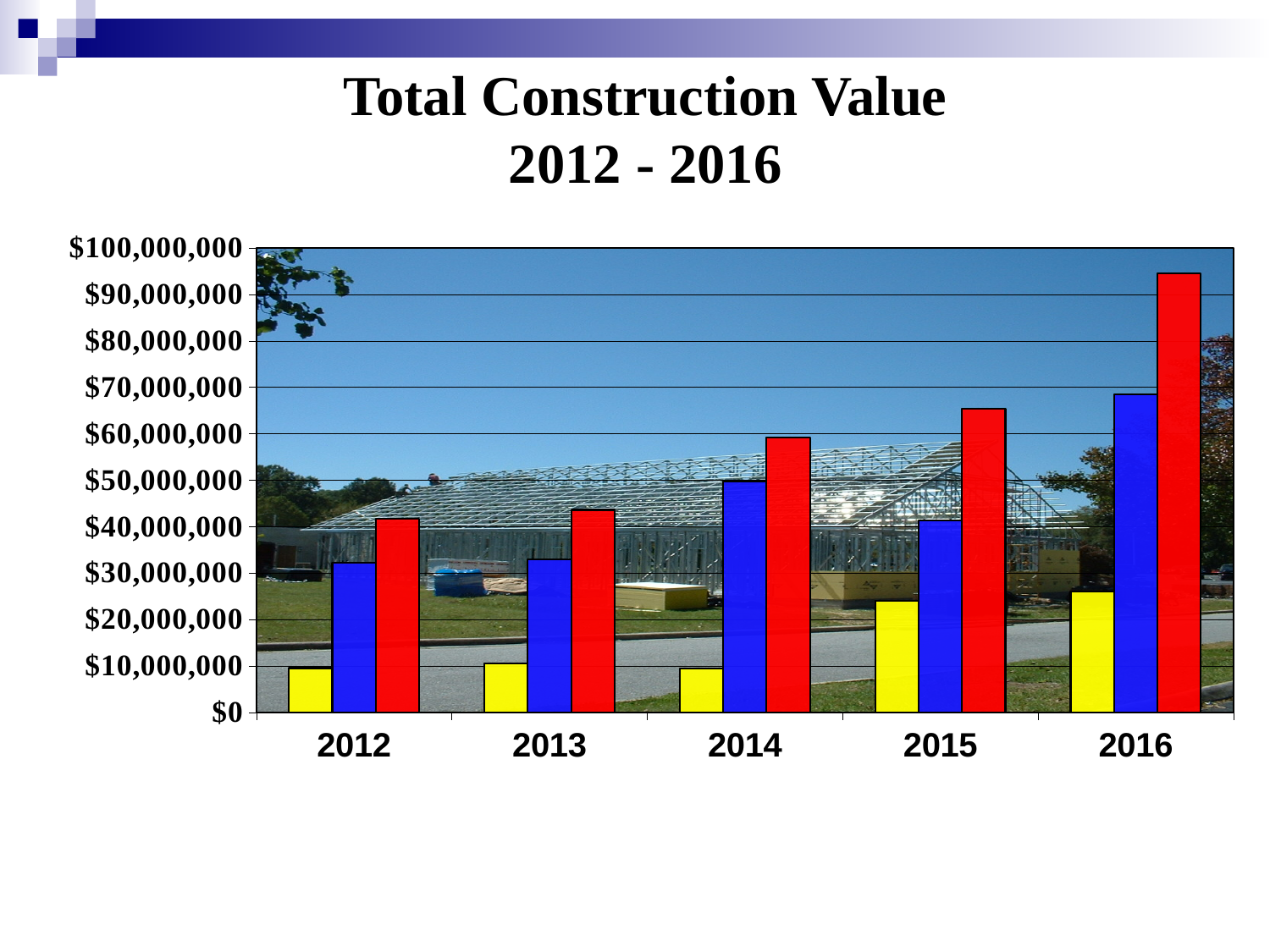
Is the yellow bar for 2012 greater or less than $20,000,000? less How many years are shown along the x axis of the chart? 5 In which year is the yellow bar the tallest? 2016 Do the red bars generally rise or fall from 2012 to 2016? rise How many bars are shown for each year in the chart? 3 Is the blue bar for 2016 greater or less than $60,000,000? greater What kind of chart is shown on the slide? bar chart Is the red bar for 2016 greater or less than $90,000,000? greater In which year is the red bar the tallest? 2016 What is the title of the chart on the slide? Total Construction Value 2012 - 2016 Which is larger, the blue bar for 2014 or the blue bar for 2015? 2014